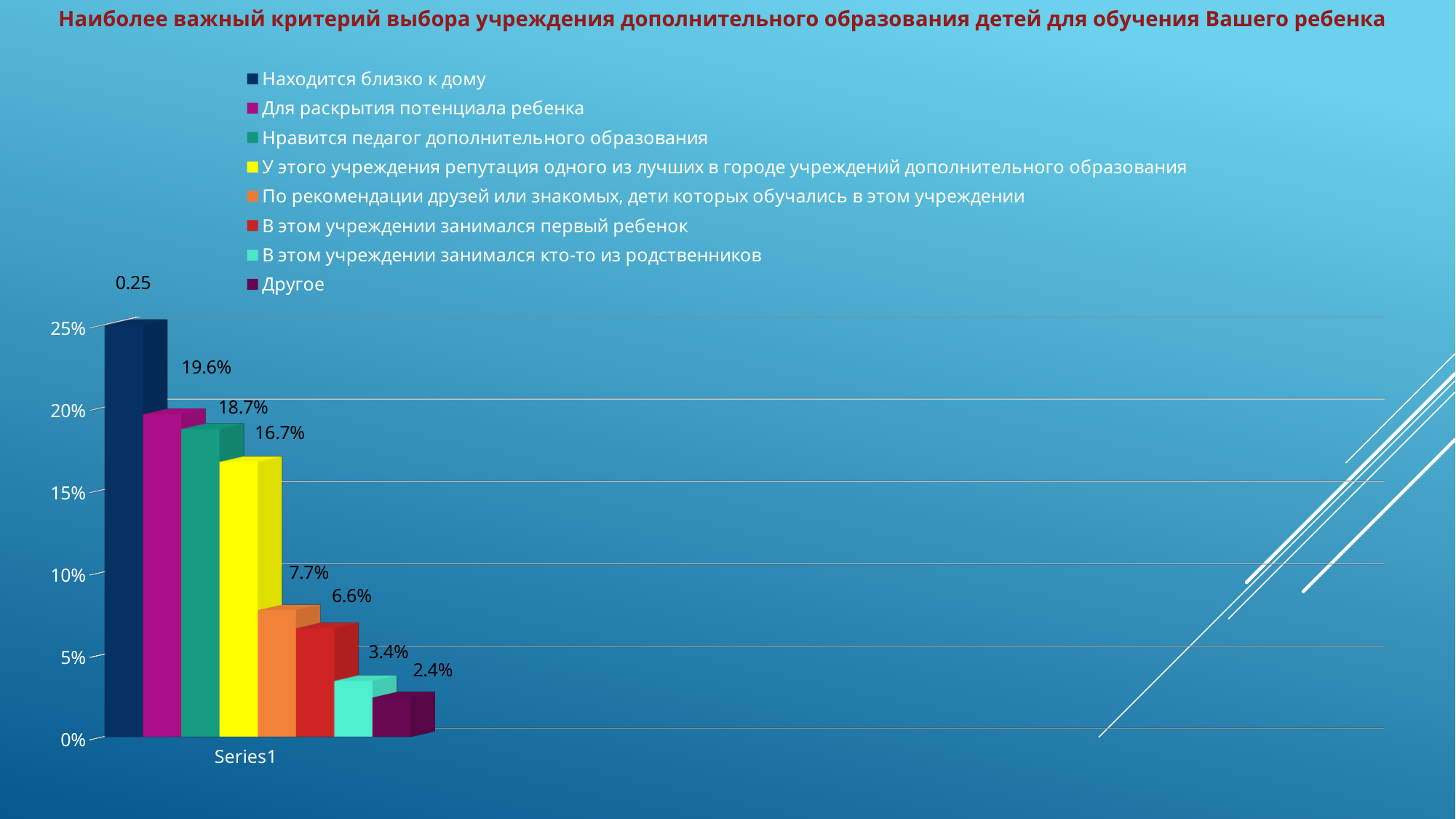
What value is shown for the series "Нравится педагог дополнительного образования"? 18.7% Which is larger: the value for "В этом учреждении занимался первый ребенок" or the value for "В этом учреждении занимался кто-то из родственников"? В этом учреждении занимался первый ребенок Is the value for "У этого учреждения репутация одного из лучших в городе учреждений дополнительного образования" greater or less than 15%? greater How many series does the legend list? 8 What is the difference between the values for "Для раскрытия потенциала ребенка" and "Нравится педагог дополнительного образования"? 0.9% What value is shown for the series "Для раскрытия потенциала ребенка"? 19.6% What kind of chart is shown on the slide? bar chart Which series has the lowest value? Другое What value is shown for the series "По рекомендации друзей или знакомых, дети которых обучались в этом учреждении"? 7.7% What value is shown for the series "Находится близко к дому"? 0.25 Which series has the highest value? Находится близко к дому What value is shown for the series "Другое"? 2.4%